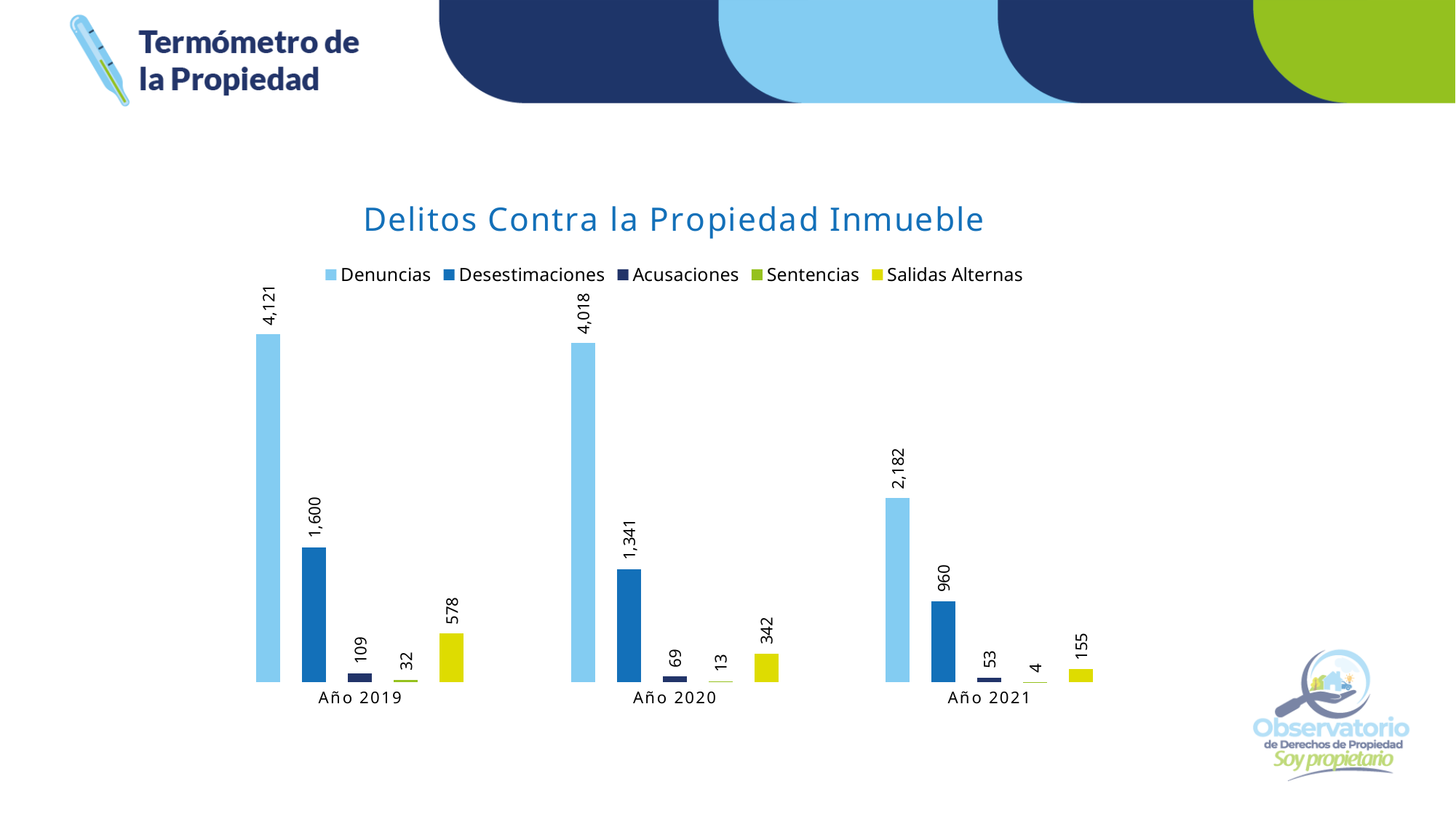
What is the difference between Denuncias in Año 2019 and Año 2020? 103 What kind of chart is shown? Bar chart Which is larger: Salidas Alternas in Año 2019 or Salidas Alternas in Año 2020? Año 2019 Do the Denuncias values rise or fall from Año 2019 to Año 2021? Fall What is the value of Desestimaciones for Año 2020? 1,341 What is the value of Sentencias for Año 2021? 4 Which year has the highest value for Denuncias? Año 2019 How many series does the legend list? 5 Which year has the lowest value for Acusaciones? Año 2021 How many years are shown on the x axis? 3 What is the value of Salidas Alternas for Año 2021? 155 What is the value of Denuncias for Año 2019? 4,121